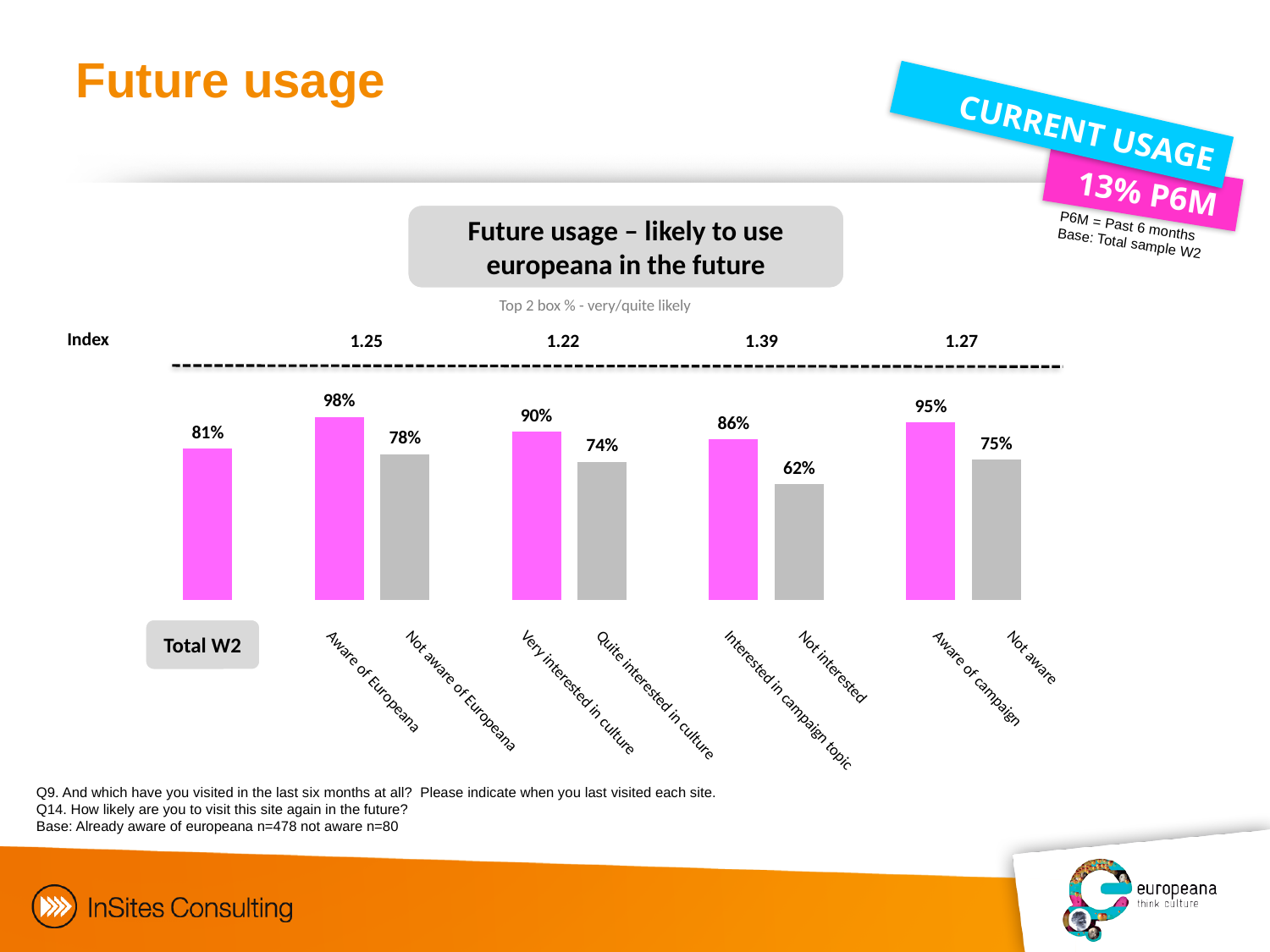
Which category has the lowest value? Not interested Which is larger, Very interested in culture or Not aware of Europeana? Very interested in culture What is the difference between Interested in campaign topic and Not interested? 24% What is the value for Total W2? 81% What is the value for Not interested? 62% Which category has the highest value? Aware of Europeana What index value is shown above the Interested in campaign topic / Not interested pair? 1.39 What is the value for Quite interested in culture? 74% What kind of chart is shown? Bar chart What is the value for Aware of Europeana? 98% What is the difference between Aware of campaign and Not aware? 20% How many bars are plotted in the chart? 9